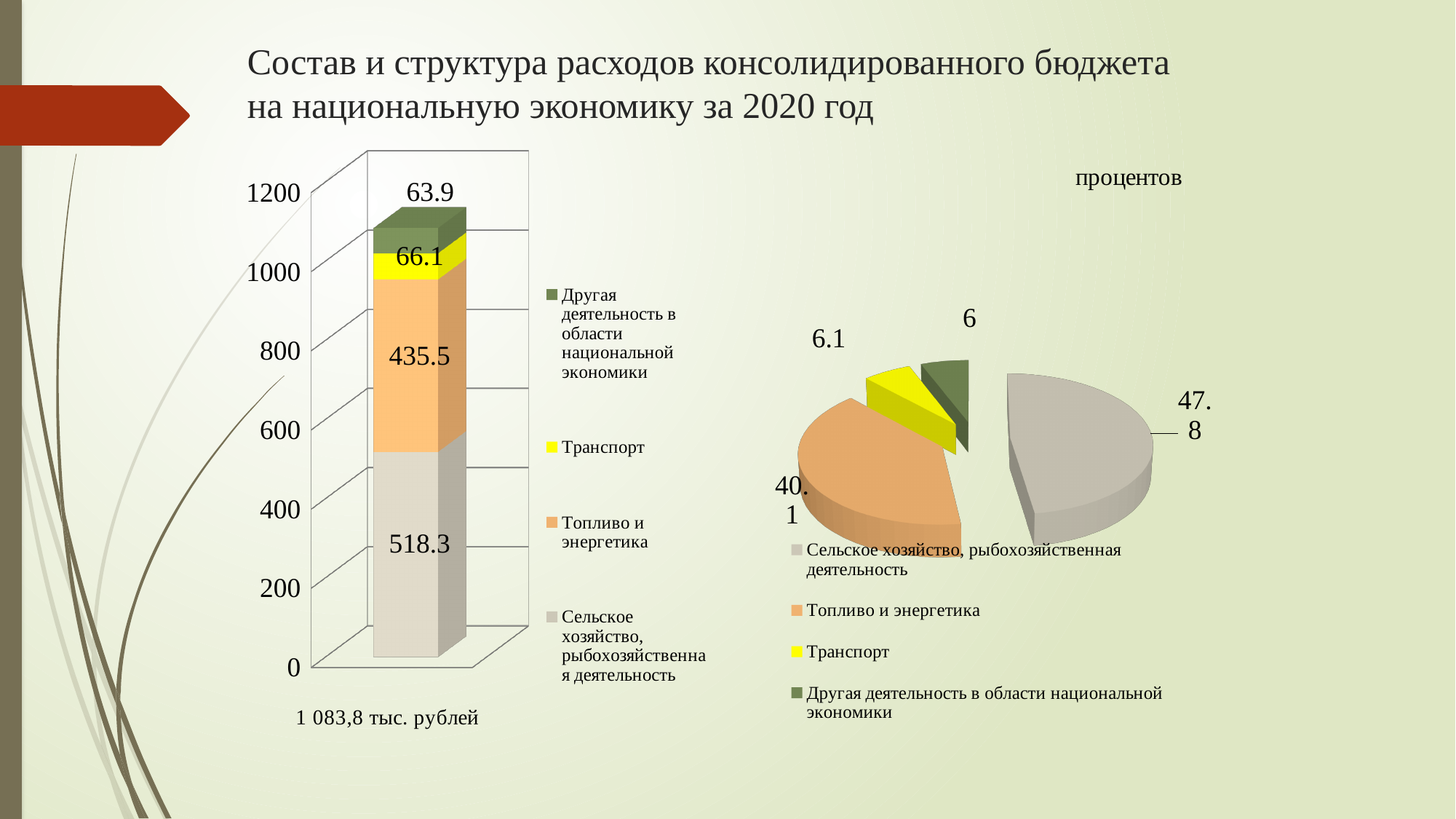
In the stacked bar chart on the left, what is the value for Топливо и энергетика? 435.5 In the stacked bar chart on the left, what is the difference between the values for Сельское хозяйство, рыбохозяйственная деятельность and Топливо и энергетика? 82.8 In the pie chart on the right, which category has the smallest slice? Другая деятельность в области национальной экономики What kind of chart is shown on the left of the slide? Stacked bar chart In the stacked bar chart on the left, what is the total of the stacked bar? 1 083,8 тыс. рублей What kind of chart is shown on the right of the slide? Pie chart In the stacked bar chart on the left, which series has the largest value? Сельское хозяйство, рыбохозяйственная деятельность In the stacked bar chart on the left, what is the value for Транспорт? 66.1 How many series does the legend of the stacked bar chart on the left list? 4 In the pie chart on the right, what share does Сельское хозяйство, рыбохозяйственная деятельность have? 47.8 In the stacked bar chart on the left, what is the value for Сельское хозяйство, рыбохозяйственная деятельность? 518.3 In the pie chart on the right, what share does Топливо и энергетика have? 40.1